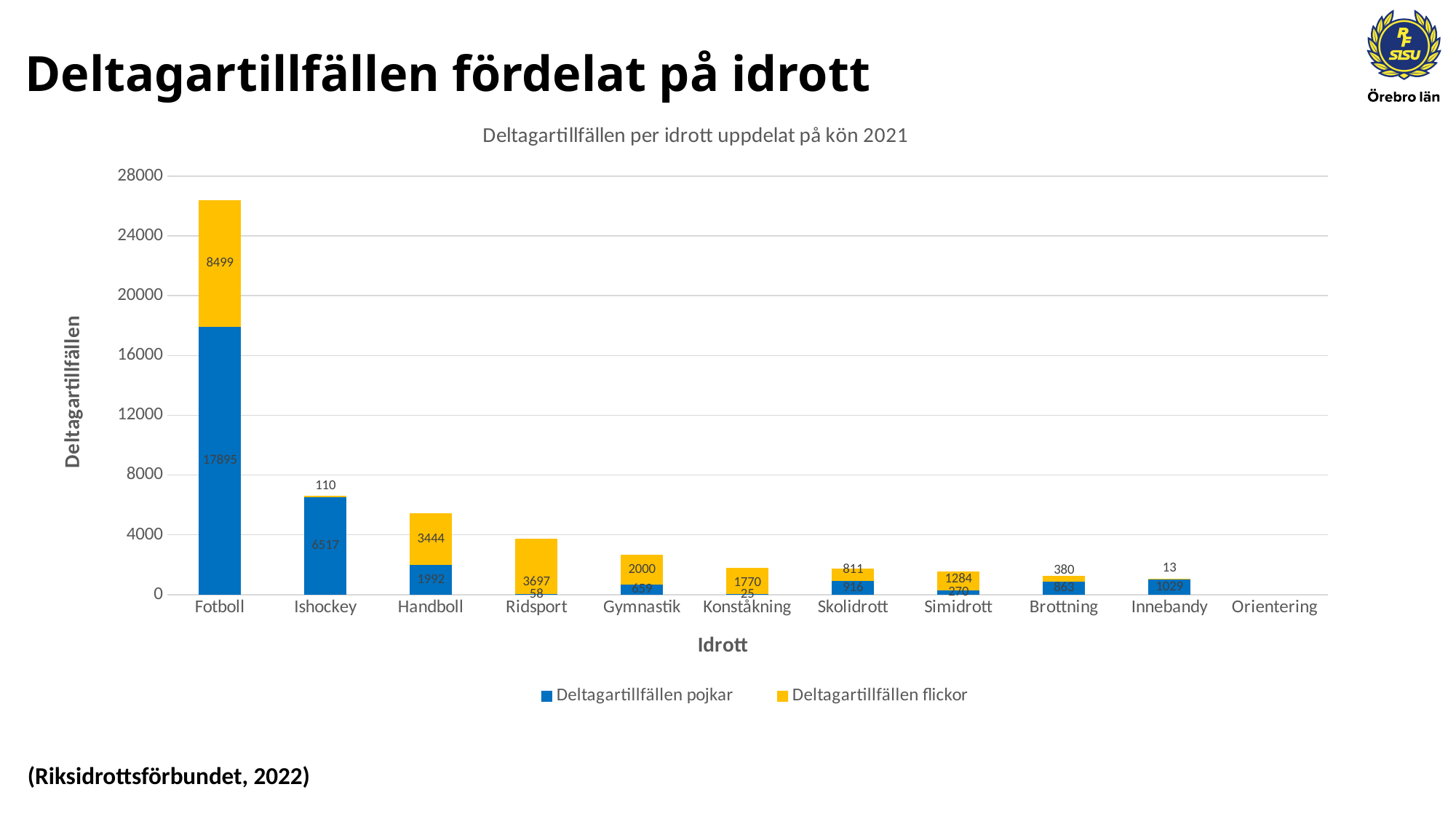
What is the difference between Deltagartillfällen pojkar and Deltagartillfällen flickor for Fotboll? 9396 Which sport has the highest value for Deltagartillfällen flickor? Fotboll How many sports are shown on the x axis? 11 What is the total stacked value for Ishockey? 6627 Which sport has the highest value for Deltagartillfällen pojkar? Fotboll What is the value of Deltagartillfällen flickor for Ridsport? 3697 What kind of chart is shown on the slide? Stacked bar chart What is the value of Deltagartillfällen pojkar for Fotboll? 17895 What is the value of Deltagartillfällen flickor for Handboll? 3444 For Handboll, which is larger: Deltagartillfällen pojkar or Deltagartillfällen flickor? Deltagartillfällen flickor Is the total stacked value for Fotboll greater or less than 24000? greater How many series does the legend list? 2